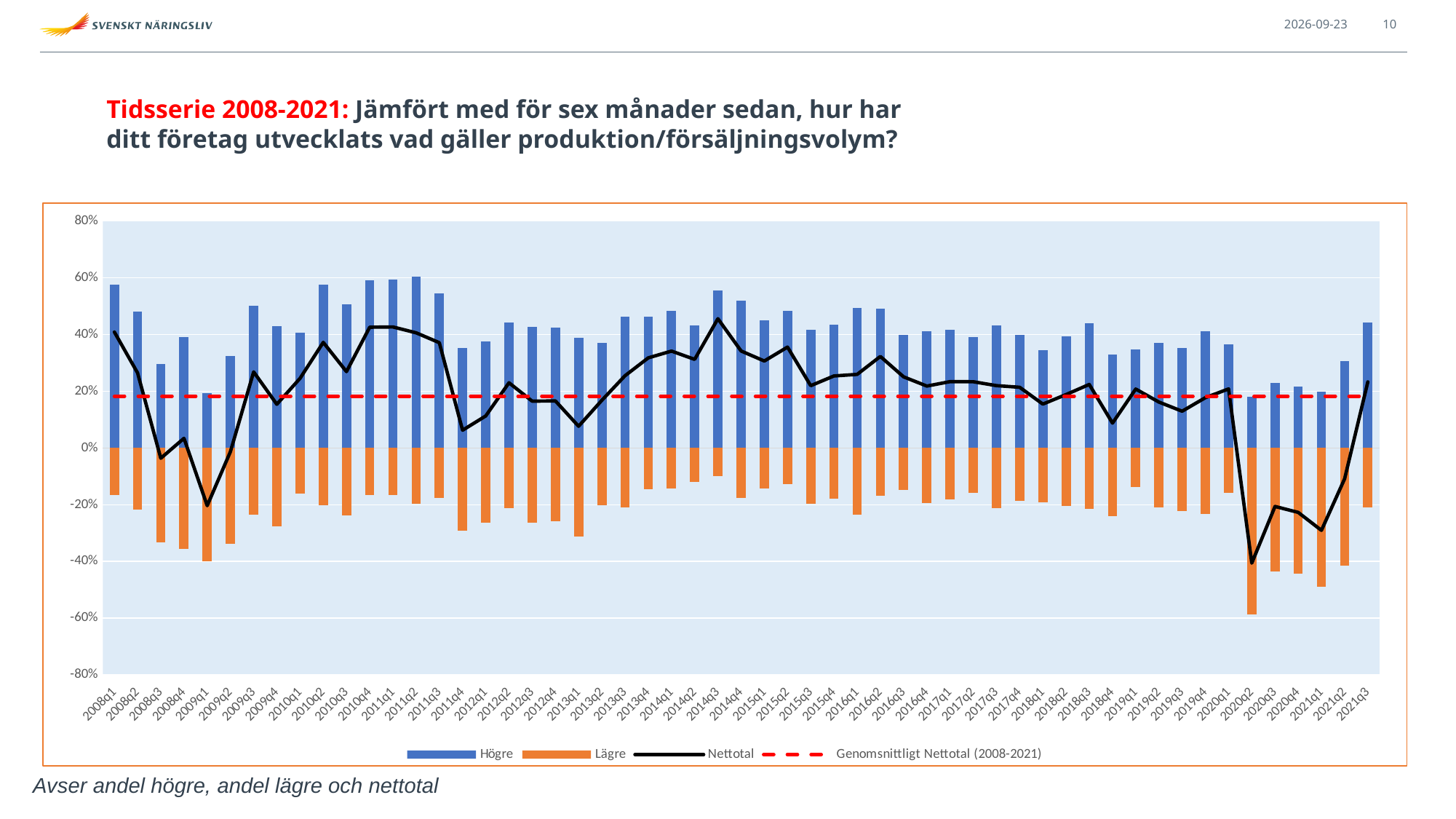
Is the Högre value for 2020q2 greater or less than 40%? less Which quarter has the lowest value for Nettotal? 2020q2 How many quarters are plotted along the x axis? 55 Does the Högre series rise or fall from 2020q2 to 2021q3? rise Which has the larger Högre value, 2008q1 or 2008q3? 2008q1 Which quarter has the lowest (most negative) value for Lägre? 2020q2 What kind of chart is shown on the slide? Bar chart with line series Is the Lägre value for 2020q2 greater or less than -40%? less Is the Högre value for 2008q1 greater or less than 40%? greater How many series does the legend list? 4 What does the red dashed line in the chart represent? Genomsnittligt Nettotal (2008-2021)